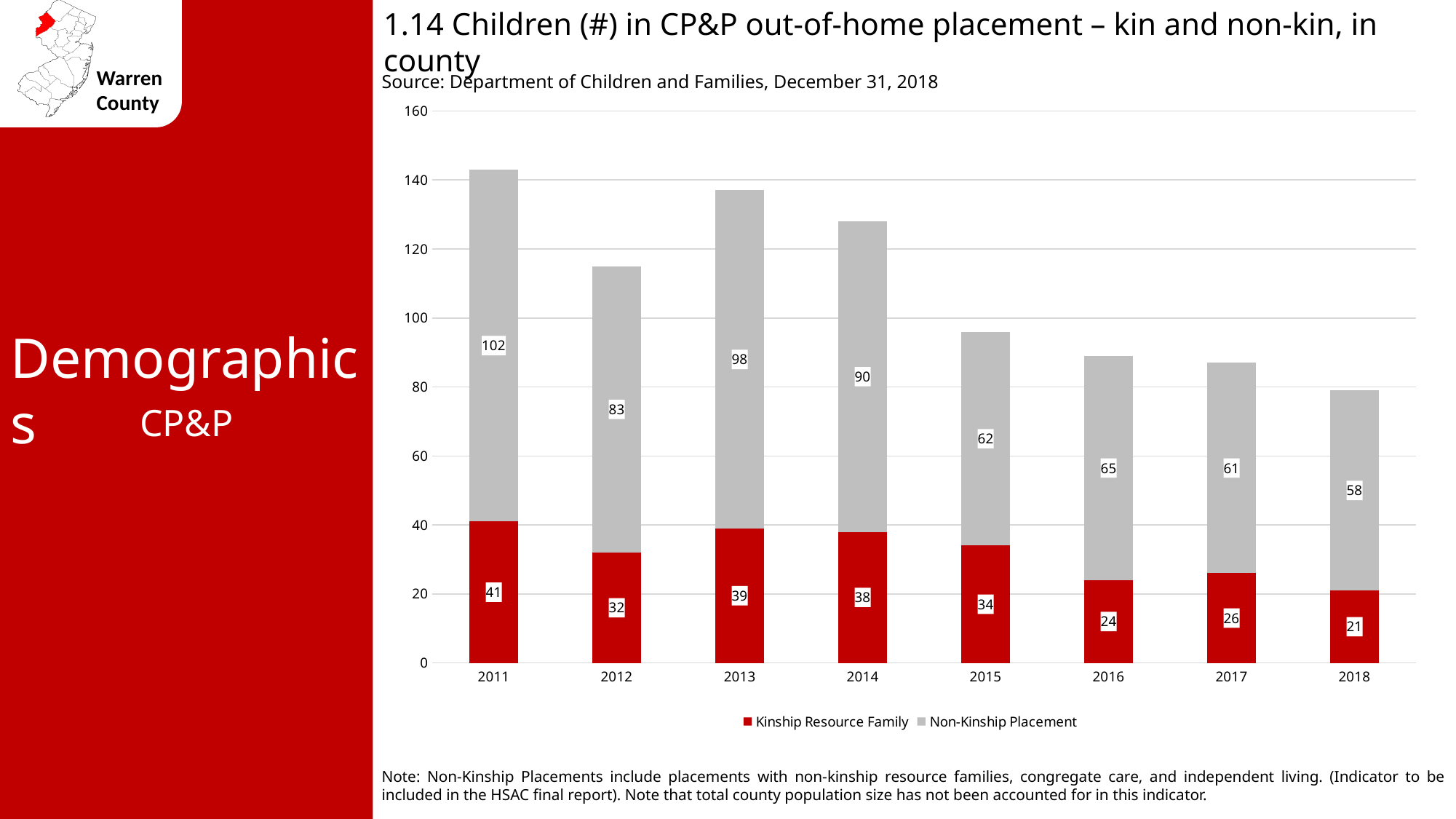
Do the Non-Kinship Placement values generally rise or fall from 2011 to 2018? Fall What is the difference between the Non-Kinship Placement values for 2013 and 2014? 8 Is the total height of the 2012 stacked bar greater or less than 100? greater What is the Non-Kinship Placement value for 2015? 62 Which year has the lowest Kinship Resource Family value? 2018 Which is larger, the Kinship Resource Family value for 2016 or for 2017? 2017 How many years are shown on the x axis? 8 What kind of chart is shown on the slide? Stacked bar chart Which year has the highest Non-Kinship Placement value? 2011 What is the total of the stacked bar for 2018? 79 What is the Kinship Resource Family value for 2011? 41 How many series does the legend list? 2